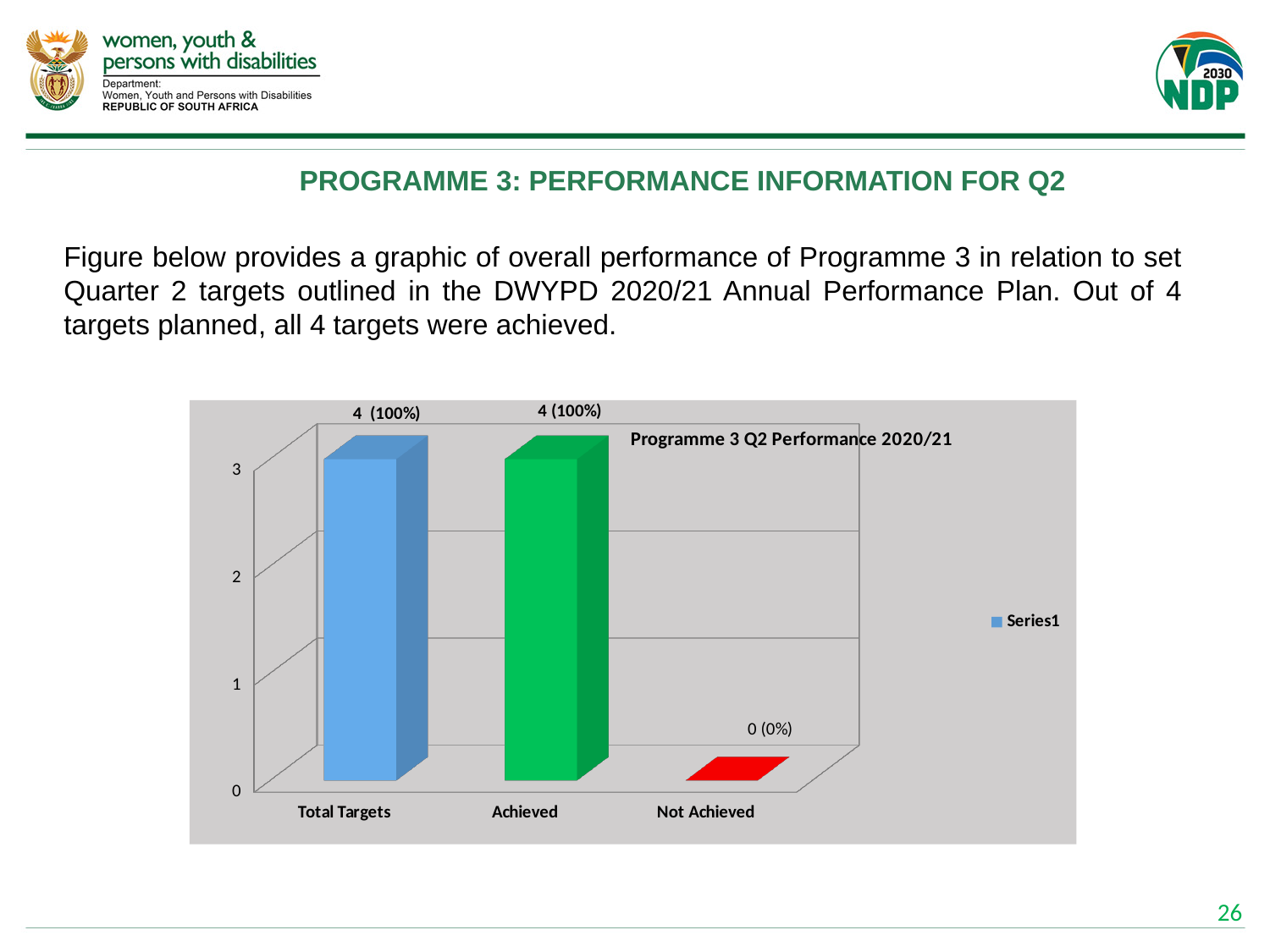
How many series does the legend list? 1 What is the difference between the number of targets Achieved and the number Not Achieved? 4 Which is larger, the value for Achieved or the value for Not Achieved? Achieved What is the title of the chart? Programme 3 Q2 Performance 2020/21 What value is shown for Achieved? 4 (100%) What kind of chart is shown on the slide? Bar chart What value is shown for Total Targets? 4 (100%) Which category has the lowest value? Not Achieved What colour is the bar for Not Achieved? Red What value is shown for Not Achieved? 0 (0%) How many categories are shown on the x axis? 3